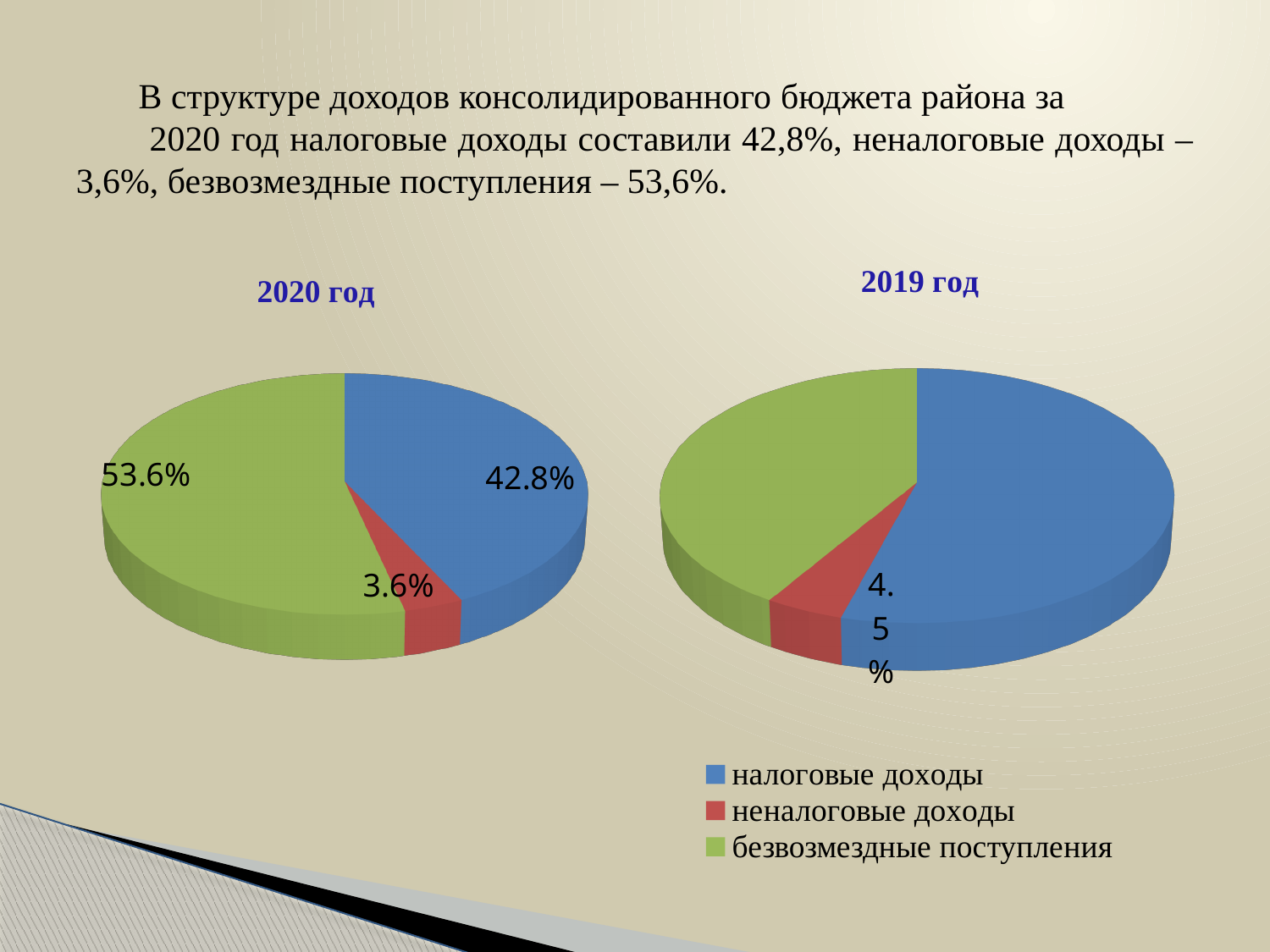
On the 2020 год pie chart, which category has the smallest share? неналоговые доходы On the 2020 год pie chart, what is the difference between the shares of безвозмездные поступления and налоговые доходы? 10.8% What type of chart is used for 2019 год? pie chart How many slices does the 2020 год pie chart have? 3 On the 2019 год pie chart, which category has the smallest share? неналоговые доходы On the 2020 год pie chart, what share is shown for налоговые доходы? 42.8% On the 2019 год pie chart, which is larger: налоговые доходы or безвозмездные поступления? налоговые доходы On the 2019 год pie chart, what share is shown for неналоговые доходы? 4.5% On the 2020 год pie chart, what share is shown for безвозмездные поступления? 53.6% On the 2020 год pie chart, which category has the largest share? безвозмездные поступления Which category is shown in blue in the legend? налоговые доходы On the 2020 год pie chart, what share is shown for неналоговые доходы? 3.6%